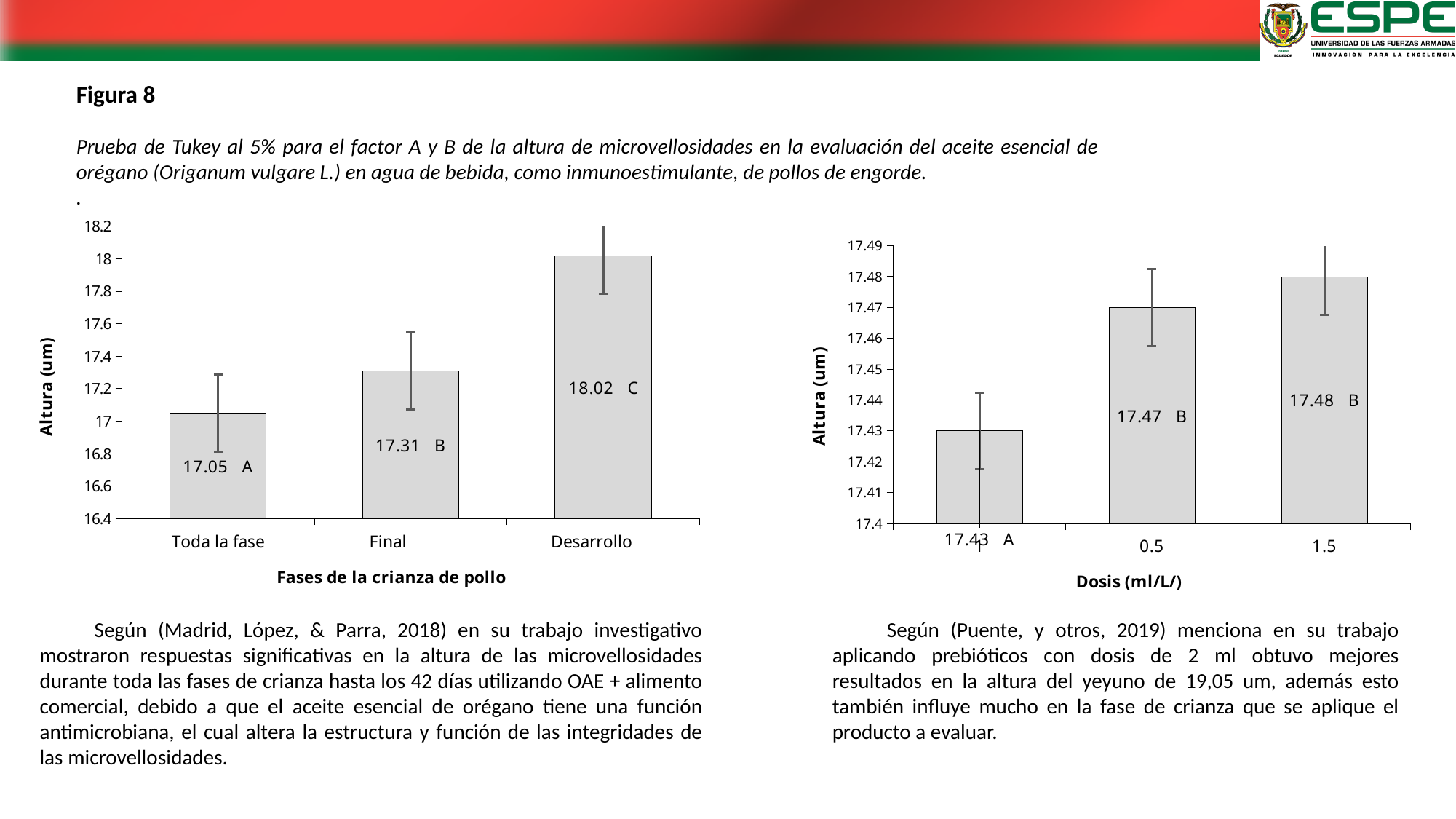
In the left chart (Fases de la crianza de pollo), do the values rise or fall from left to right along the x axis? rise In the left chart (Fases de la crianza de pollo), what is the value for Toda la fase? 17.05 In the left chart (Fases de la crianza de pollo), what is the difference between the values for Desarrollo and Final? 0.71 What kind of chart is the right chart (Dosis (ml/L/))? bar chart What is the y-axis title of the right chart (Dosis (ml/L/))? Altura (um) In the right chart (Dosis (ml/L/)), what is the value for the 1.5 dose? 17.48 In the left chart (Fases de la crianza de pollo), is the value for Desarrollo greater or less than 17.8? greater In the left chart (Fases de la crianza de pollo), what is the value for Desarrollo? 18.02 In the left chart (Fases de la crianza de pollo), which is larger, the value for Final or the value for Toda la fase? Final In the right chart (Dosis (ml/L/)), how many categories are plotted? 3 In the left chart (Fases de la crianza de pollo), which category has the lowest value? Toda la fase In the left chart (Fases de la crianza de pollo), which category has the highest value? Desarrollo